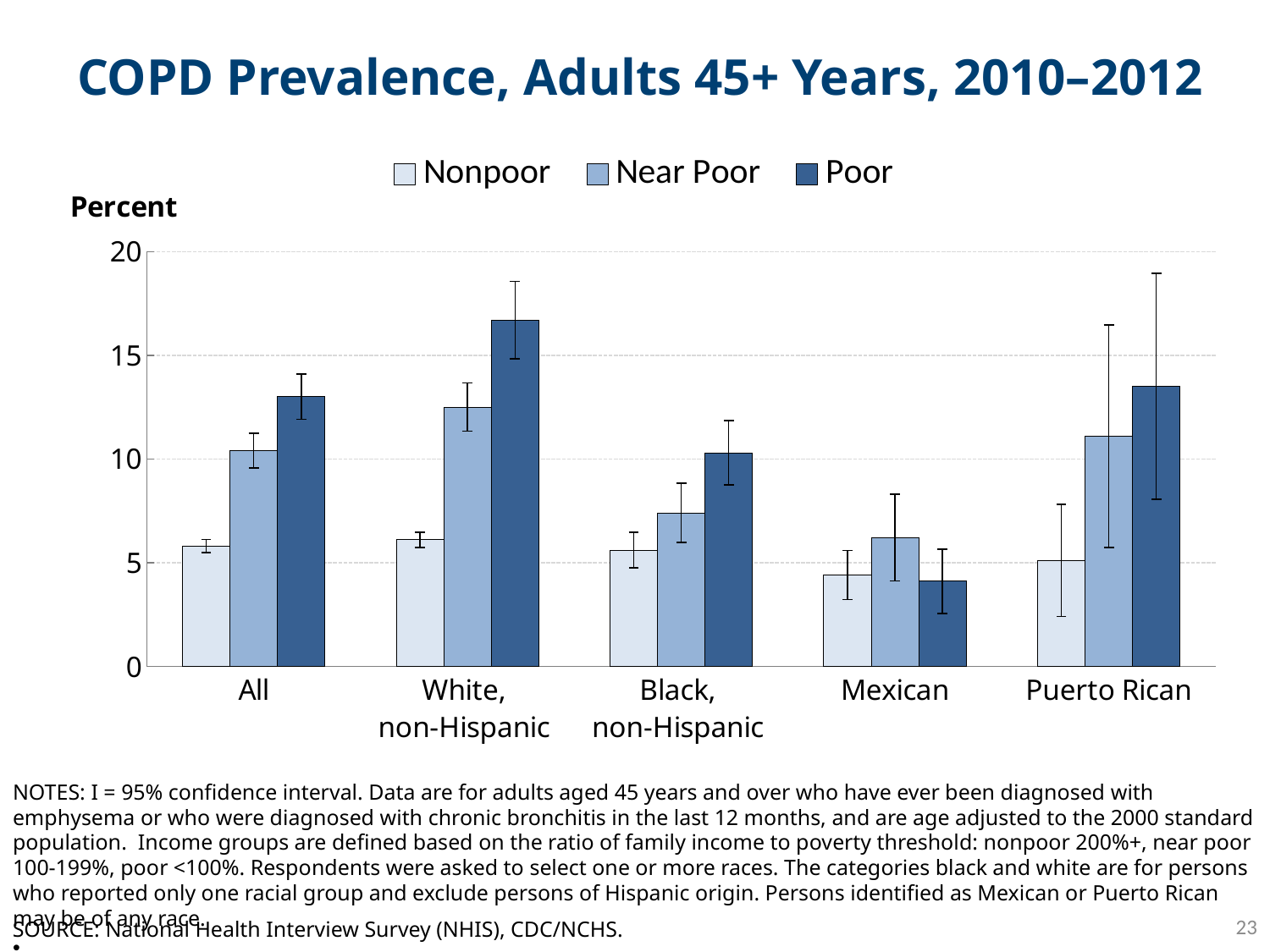
Is the Nonpoor value for All greater or less than 10? less Is the Poor value for Puerto Rican greater or less than 10? greater Which category has the highest Poor bar? White, non-Hispanic Is the Poor value for White, non-Hispanic greater or less than 15? greater For Mexican, which is larger: the Near Poor value or the Poor value? Near Poor Which is larger: the Poor value for All or the Poor value for Black, non-Hispanic? All What is the label on the vertical axis? Percent What kind of chart is shown on the slide? Bar chart Which category has the lowest Poor bar? Mexican How many population categories are shown on the x axis? 5 How many series does the legend list? 3